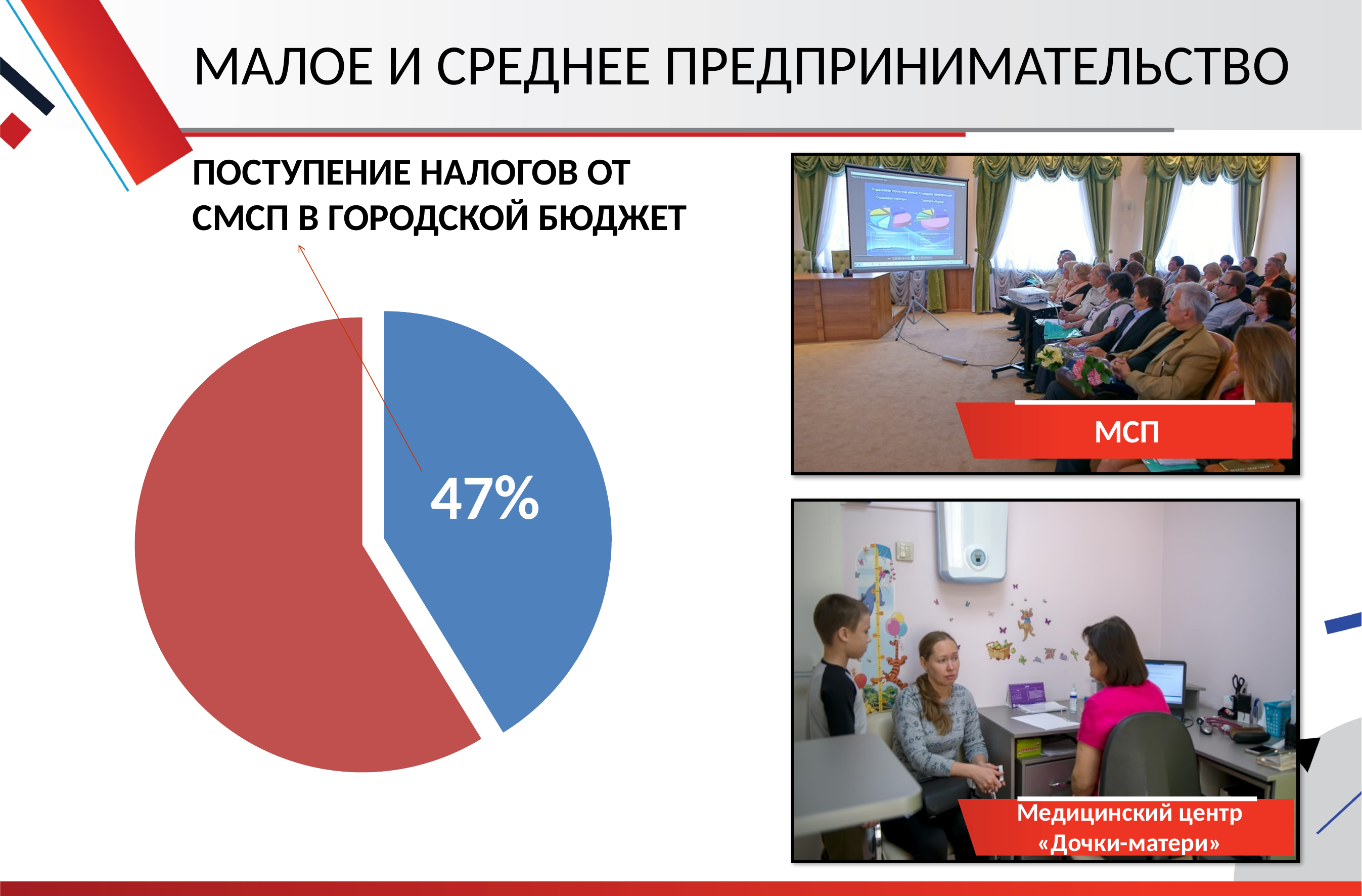
Is the share of the red slice in the pie chart greater or less than 50%? greater What percentage is printed on the blue slice of the pie chart? 47% What kind of chart is shown on the slide? pie chart Is the share of the blue slice in the pie chart greater or less than 50%? less What is the heading text placed above the pie chart? ПОСТУПЛЕНИЕ НАЛОГОВ ОТ СМСП В ГОРОДСКОЙ БЮДЖЕТ Which slice of the pie chart is larger, the red one or the blue one? red How many slices does the pie chart have? 2 Which slice of the pie chart is the smallest? the blue slice (47%) Which slice of the pie chart does the arrow from the heading point to? the blue slice (47%) What colour is the slice of the pie chart labelled 47%? blue